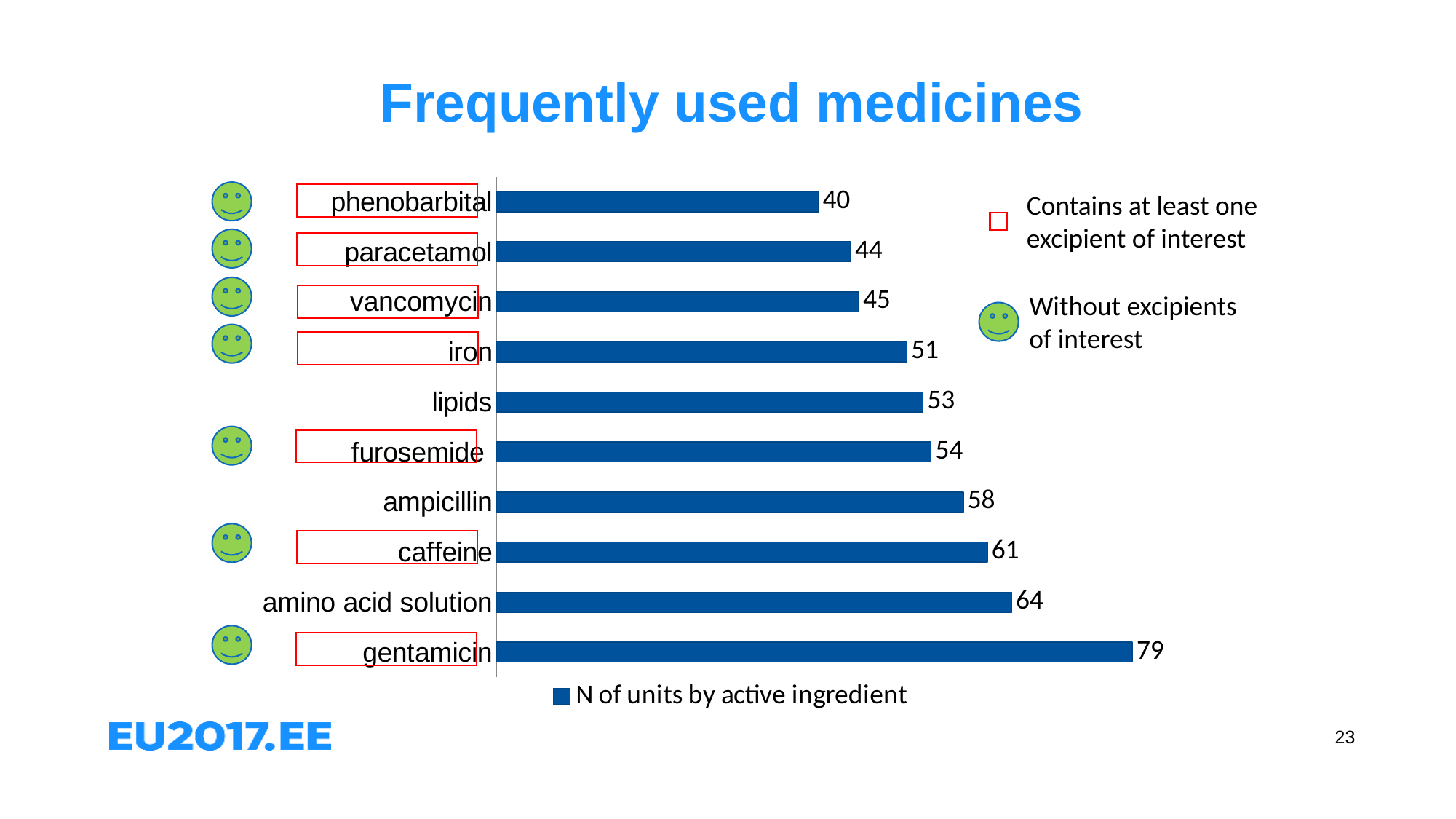
What is the legend entry for the plotted series? N of units by active ingredient What is the number of units for paracetamol? 44 What is the number of units for amino acid solution? 64 How many series does the legend list? 1 Which has more units, ampicillin or lipids? ampicillin What kind of chart is shown on the slide? bar chart How many active ingredients are shown in the chart? 10 What is the difference in units between caffeine and furosemide? 7 Which active ingredient has the lowest number of units? phenobarbital What is the difference in units between gentamicin and phenobarbital? 39 Which active ingredient has the highest number of units? gentamicin What is the number of units for gentamicin? 79